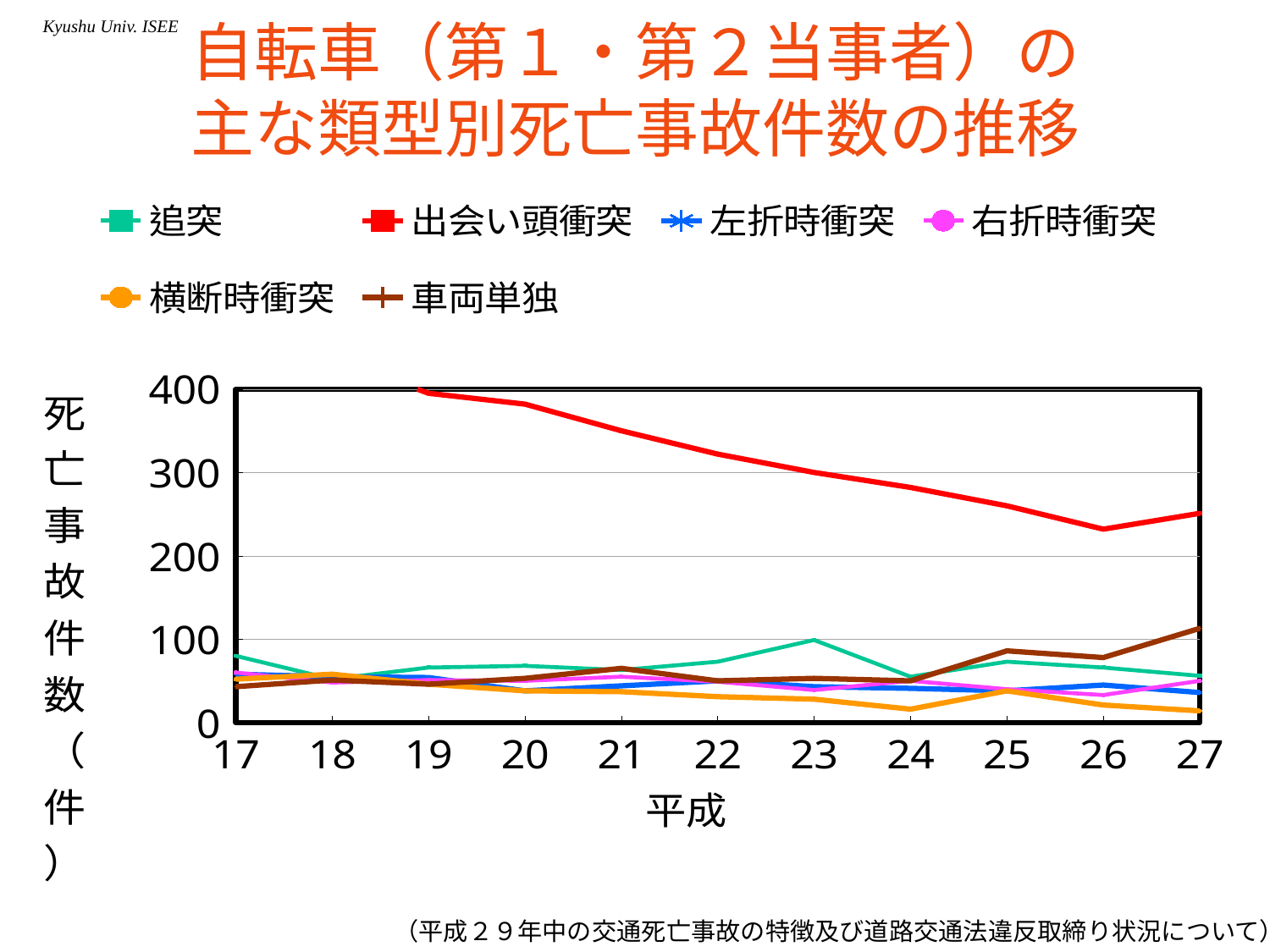
Which series has the highest values across the chart? 出会い頭衝突 Does the value for 出会い頭衝突 rise or fall from 平成19 to 平成26? fall Is the value for 出会い頭衝突 in 平成20 greater or less than 300? greater Is the value for 出会い頭衝突 in 平成26 greater or less than 300? less Does the value for 車両単独 rise or fall from 平成24 to 平成27? rise How many series does the legend list? 6 What is the label of the x axis? 平成 In 平成27, which is larger: 出会い頭衝突 or 車両単独? 出会い頭衝突 How many years are shown along the x axis? 11 Which series has the lowest value in 平成27? 横断時衝突 Is the value for 横断時衝突 in 平成27 greater or less than 50? less What kind of chart is shown on the slide? line chart